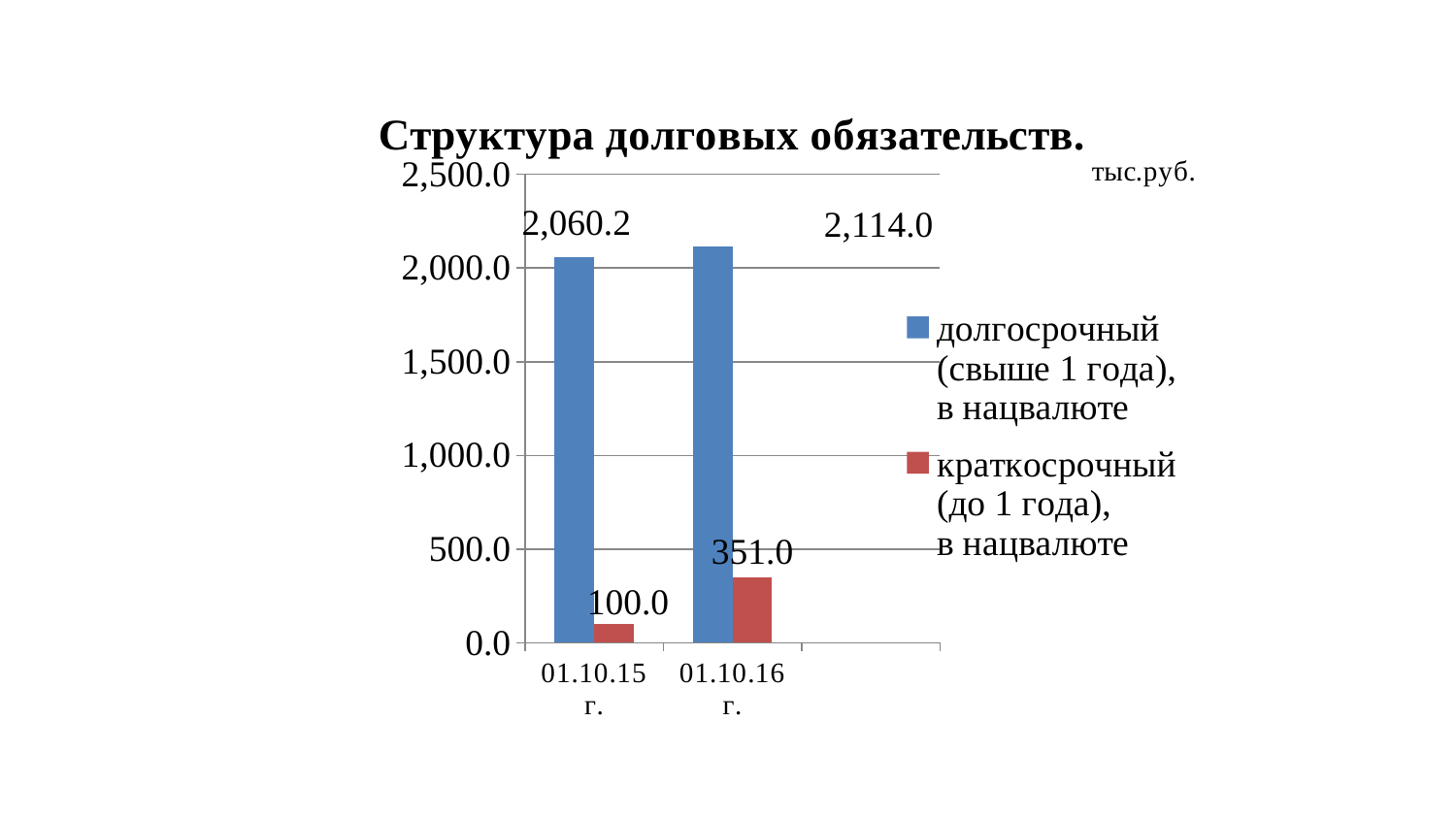
Is the value of долгосрочный (свыше 1 года), в нацвалюте for 01.10.15 г. greater or less than 2,000.0? greater What is the value of краткосрочный (до 1 года), в нацвалюте for 01.10.15 г.? 100.0 Which date has the higher value for краткосрочный (до 1 года), в нацвалюте? 01.10.16 г. What is the title of the chart? Структура долговых обязательств. What is the value of долгосрочный (свыше 1 года), в нацвалюте for 01.10.16 г.? 2,114.0 What is the value of долгосрочный (свыше 1 года), в нацвалюте for 01.10.15 г.? 2,060.2 What is the value of краткосрочный (до 1 года), в нацвалюте for 01.10.16 г.? 351.0 What is the difference between долгосрочный and краткосрочный values for 01.10.16 г.? 1,763.0 By how much did краткосрочный (до 1 года), в нацвалюте increase from 01.10.15 г. to 01.10.16 г.? 251.0 What kind of chart is shown on the slide? bar chart How many dates (categories) are shown on the x axis? 2 How many series does the legend list? 2